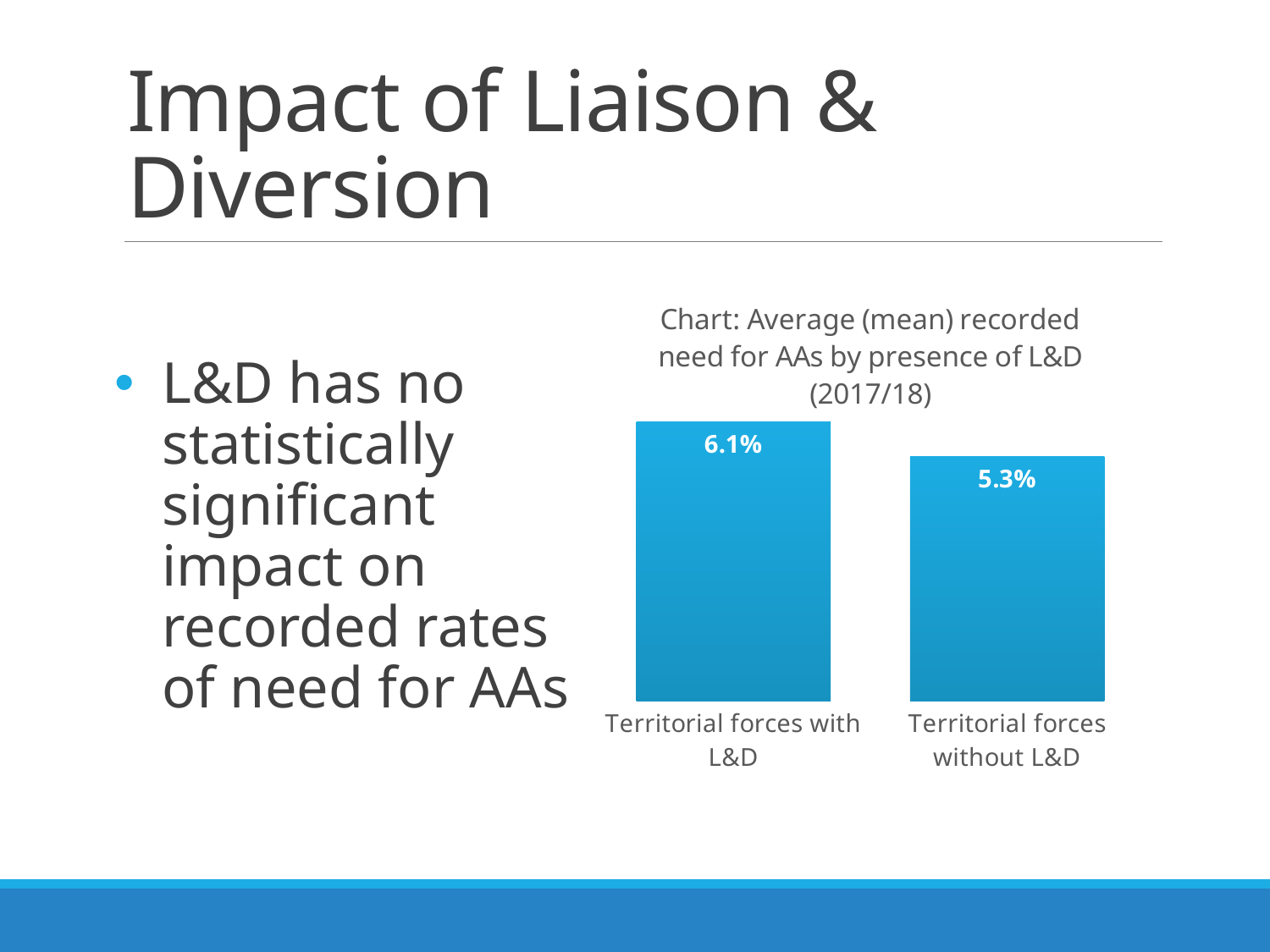
Is the value for territorial forces with L&D larger or smaller than the value for territorial forces without L&D? larger What is the difference between the values for territorial forces with L&D and without L&D? 0.8% Which category has the higher average recorded need for AAs? Territorial forces with L&D What kind of chart is shown on the slide? bar chart What is the average recorded need for AAs for territorial forces without L&D? 5.3% How many categories are shown in the chart? 2 What is the average recorded need for AAs for territorial forces with L&D? 6.1% What year does the chart title say the data is for? 2017/18 Which category has the lower average recorded need for AAs? Territorial forces without L&D What is the title of the chart? Chart: Average (mean) recorded need for AAs by presence of L&D (2017/18)